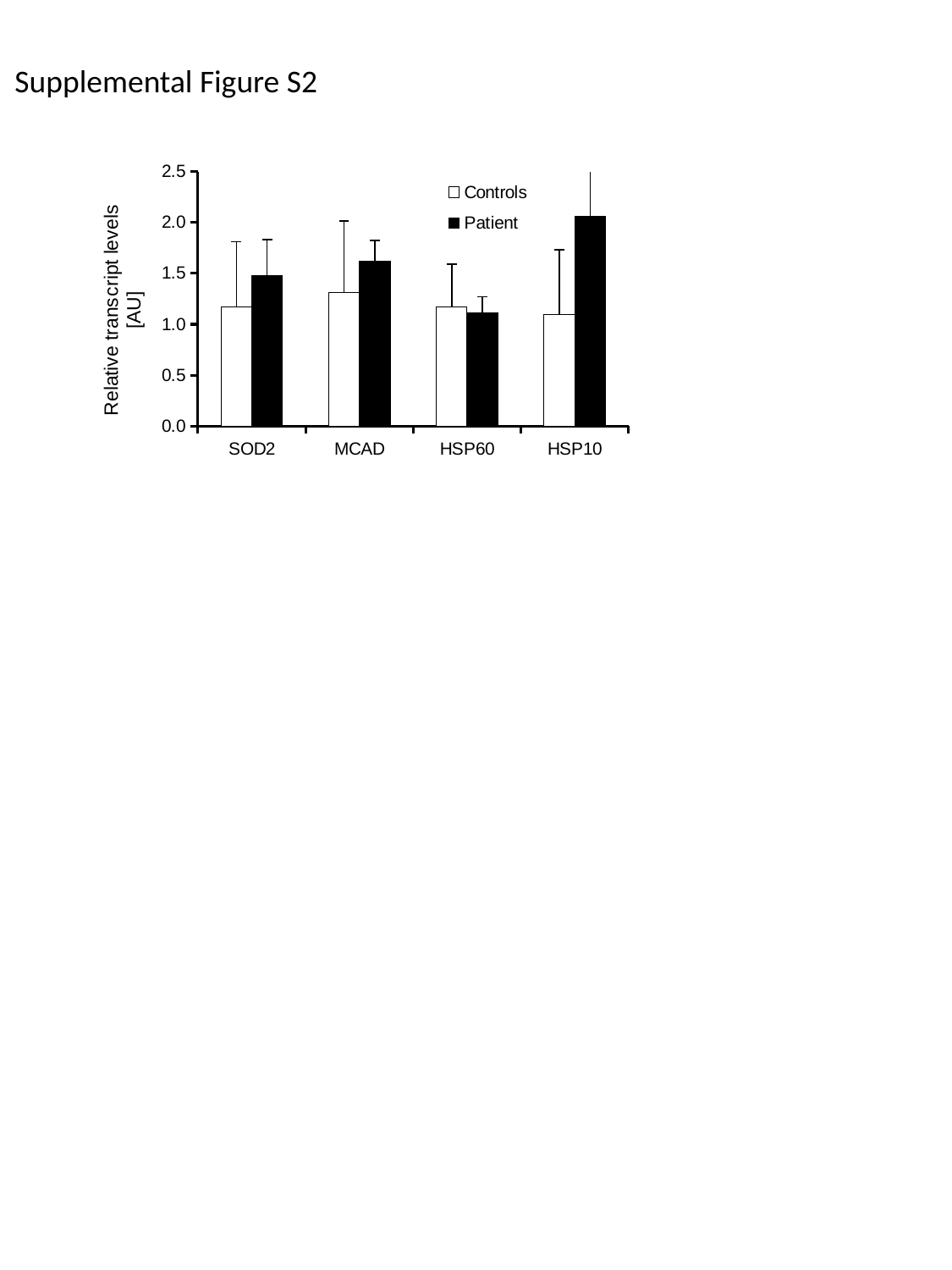
Which category has the highest Patient value? HSP10 For HSP10, which is larger, the Controls value or the Patient value? Patient How many categories are shown on the x axis? 4 How many series does the legend list? 2 For SOD2, which is larger, the Controls value or the Patient value? Patient Is the Controls value for HSP10 greater or less than 1.5? less Is the Patient value for MCAD greater or less than 1.5? greater Is the Controls value for SOD2 greater or less than 1.5? less Which category has the lowest Patient value? HSP60 What kind of chart is shown on the slide? bar chart What is the label of the y axis? Relative transcript levels [AU]